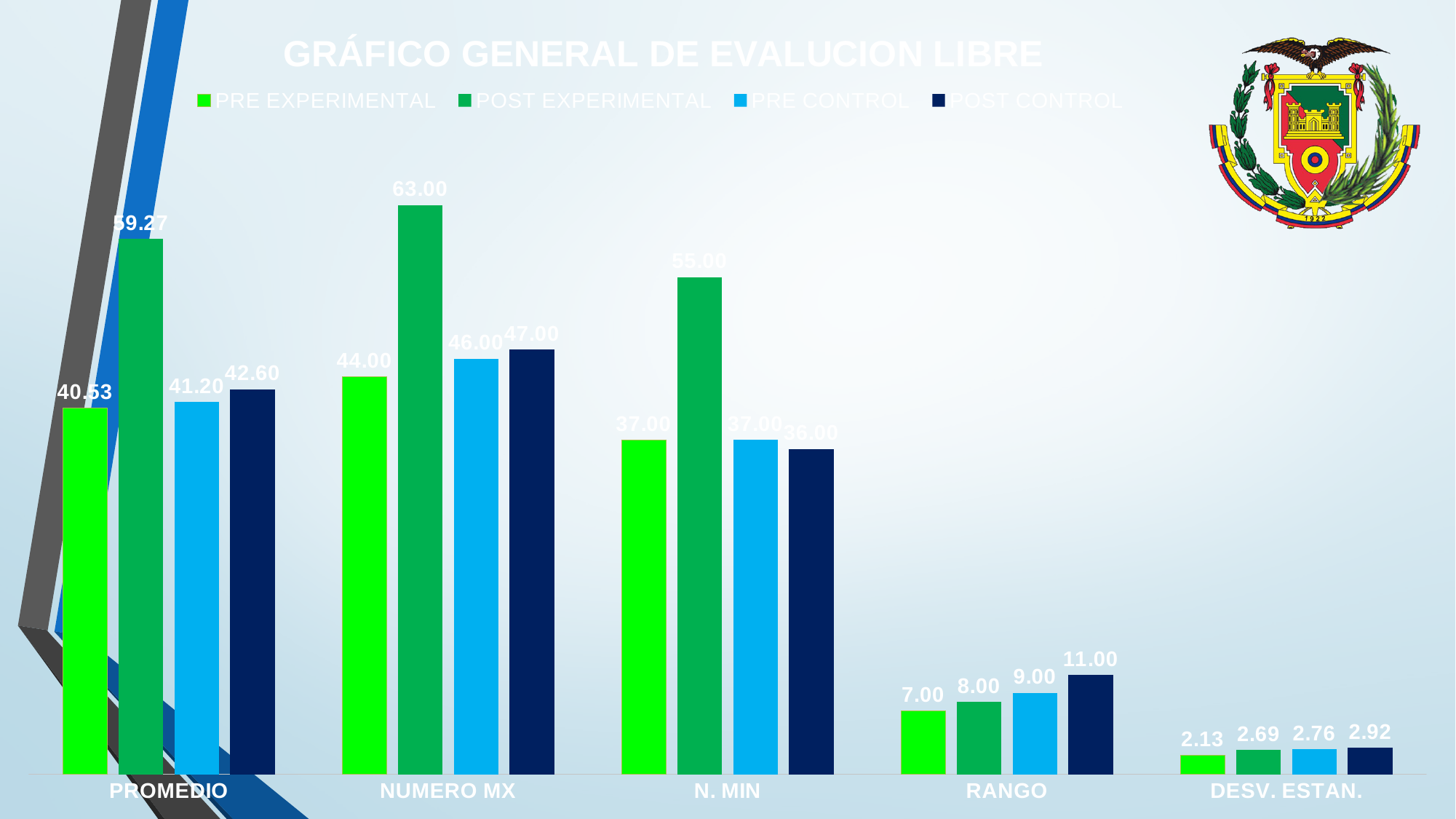
What is the value of POST CONTROL for RANGO? 11.00 What is the title of the chart? GRÁFICO GENERAL DE EVALUCION LIBRE What is the value of PRE CONTROL for NUMERO MX? 46.00 Which series has the highest value for NUMERO MX? POST EXPERIMENTAL What is the difference between POST EXPERIMENTAL and PRE EXPERIMENTAL for PROMEDIO? 18.74 How many series does the legend list? 4 Which series has the lowest value for N. MIN? POST CONTROL What is the value of POST EXPERIMENTAL for PROMEDIO? 59.27 What kind of chart is shown on the slide? Bar chart Which is larger for RANGO: PRE CONTROL or POST EXPERIMENTAL? PRE CONTROL What is the value of PRE EXPERIMENTAL for DESV. ESTAN.? 2.13 How many categories are shown on the x axis? 5